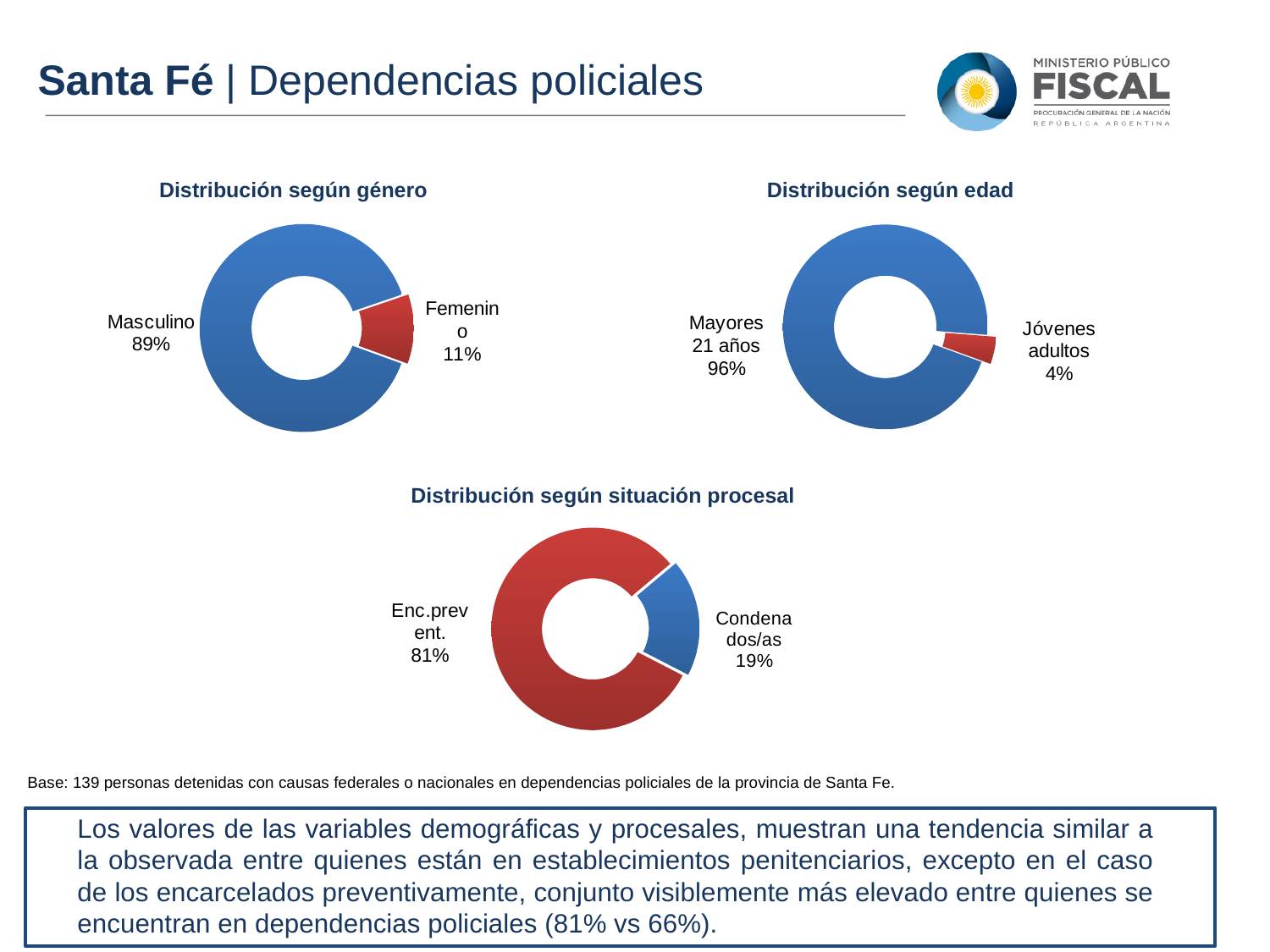
In the 'Distribución según género' chart, what share is Femenino? 11% In the 'Distribución según situación procesal' chart, what share is Enc.prevent.? 81% In the 'Distribución según situación procesal' chart, what share is Condenados/as? 19% In the 'Distribución según edad' chart, which category has the smallest share? Jóvenes adultos In the 'Distribución según edad' chart, what share is Mayores 21 años? 96% What kind of chart is 'Distribución según situación procesal'? Doughnut chart In the 'Distribución según edad' chart, what share is Jóvenes adultos? 4% In the 'Distribución según género' chart, which category has the largest share? Masculino In the 'Distribución según género' chart, how many categories are shown? 2 In the 'Distribución según género' chart, what share is Masculino? 89% In the 'Distribución según situación procesal' chart, what colour is the Enc.prevent. slice? Red In the 'Distribución según situación procesal' chart, what is the difference in percentage points between Enc.prevent. and Condenados/as? 62